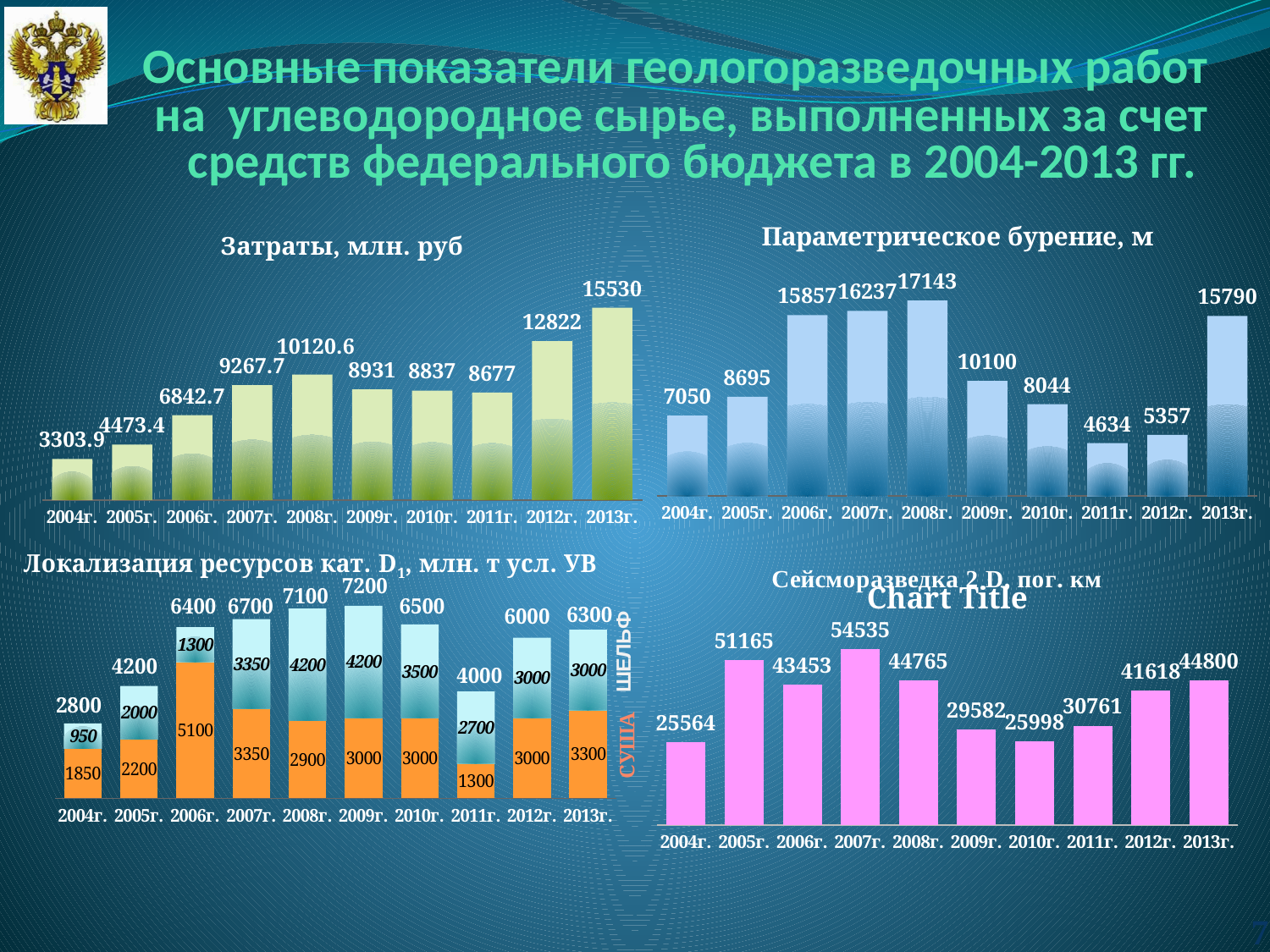
In the chart titled "Локализация ресурсов кат. D1, млн. т усл. УВ", what is the ШЕЛЬФ value for 2011г.? 2700 In the chart titled "Локализация ресурсов кат. D1, млн. т усл. УВ", what is the СУША value for 2006г.? 5100 In the chart titled "Сейсморазведка 2 D, пог. км", how many years are shown on the x axis? 10 In the chart titled "Параметрическое бурение, м", what is the value for 2011г.? 4634 In the chart titled "Затраты, млн. руб", which year has the lowest value? 2004г. In the chart titled "Параметрическое бурение, м", which year has the highest value? 2008г. In the chart titled "Затраты, млн. руб", what is the difference between the values for 2012г. and 2011г.? 4145 What kind of chart is the one titled "Сейсморазведка 2 D, пог. км"? bar chart In the chart titled "Сейсморазведка 2 D, пог. км", what is the value for 2007г.? 54535 In the chart titled "Затраты, млн. руб", what is the value for 2013г.? 15530 In the chart titled "Параметрическое бурение, м", which is larger: the value for 2006г. or the value for 2013г.? 2006г. In the chart titled "Локализация ресурсов кат. D1, млн. т усл. УВ", what is the total of the stacked bar for 2009г.? 7200